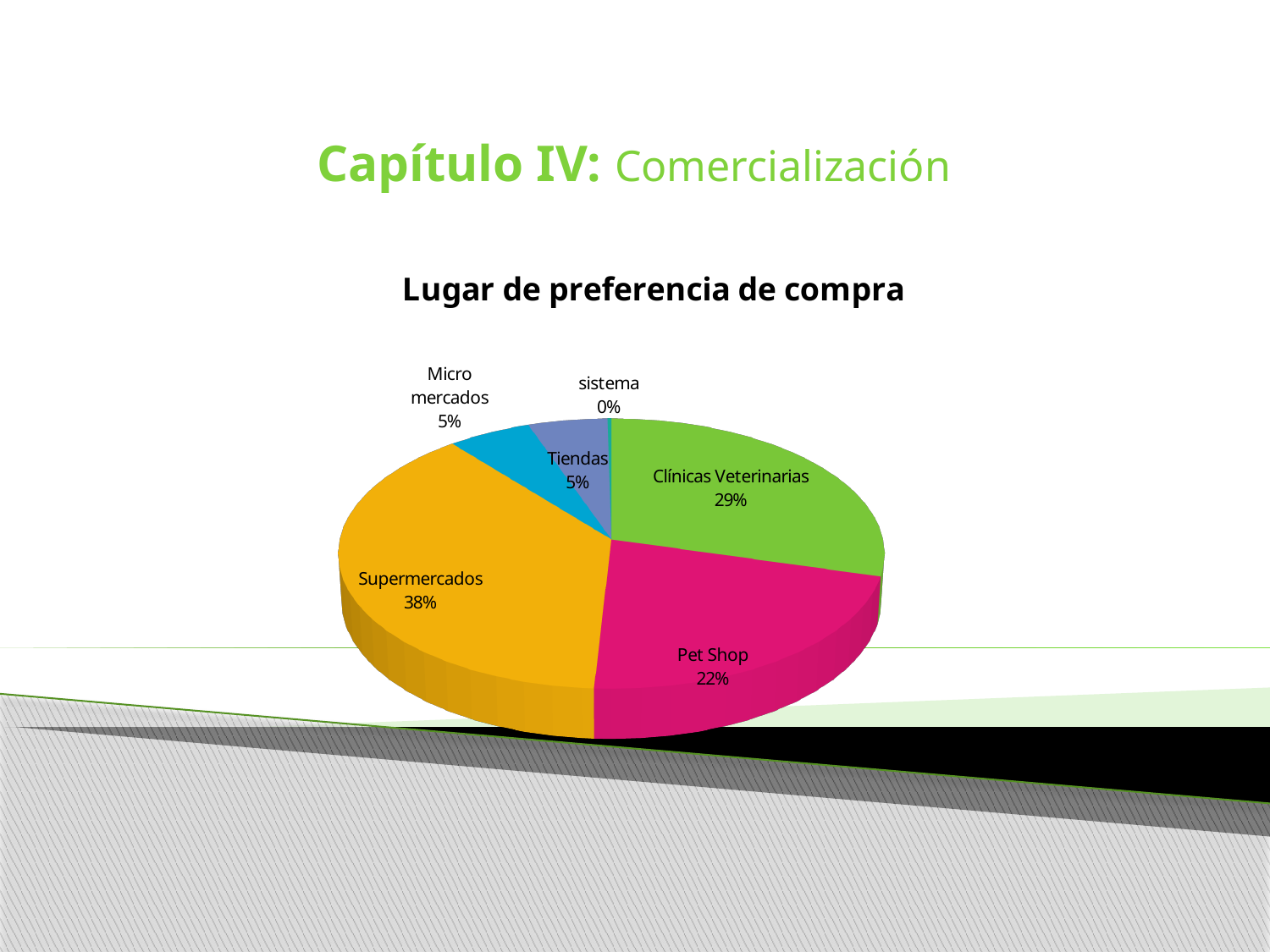
What share of the pie does Clínicas Veterinarias represent? 29% Which category has the largest share of the pie? Supermercados What is the title of the chart? Lugar de preferencia de compra How many categories are shown in the pie chart? 6 Which category has the smallest share of the pie? sistema What type of chart is shown on the slide? Pie chart What is the difference between the shares of Supermercados and Pet Shop? 16% What is the value shown for Pet Shop? 22% What share of the pie does Supermercados represent? 38% What is the value shown for Tiendas? 5% What is the value shown for sistema? 0% Which is larger, the share for Clínicas Veterinarias or the share for Pet Shop? Clínicas Veterinarias